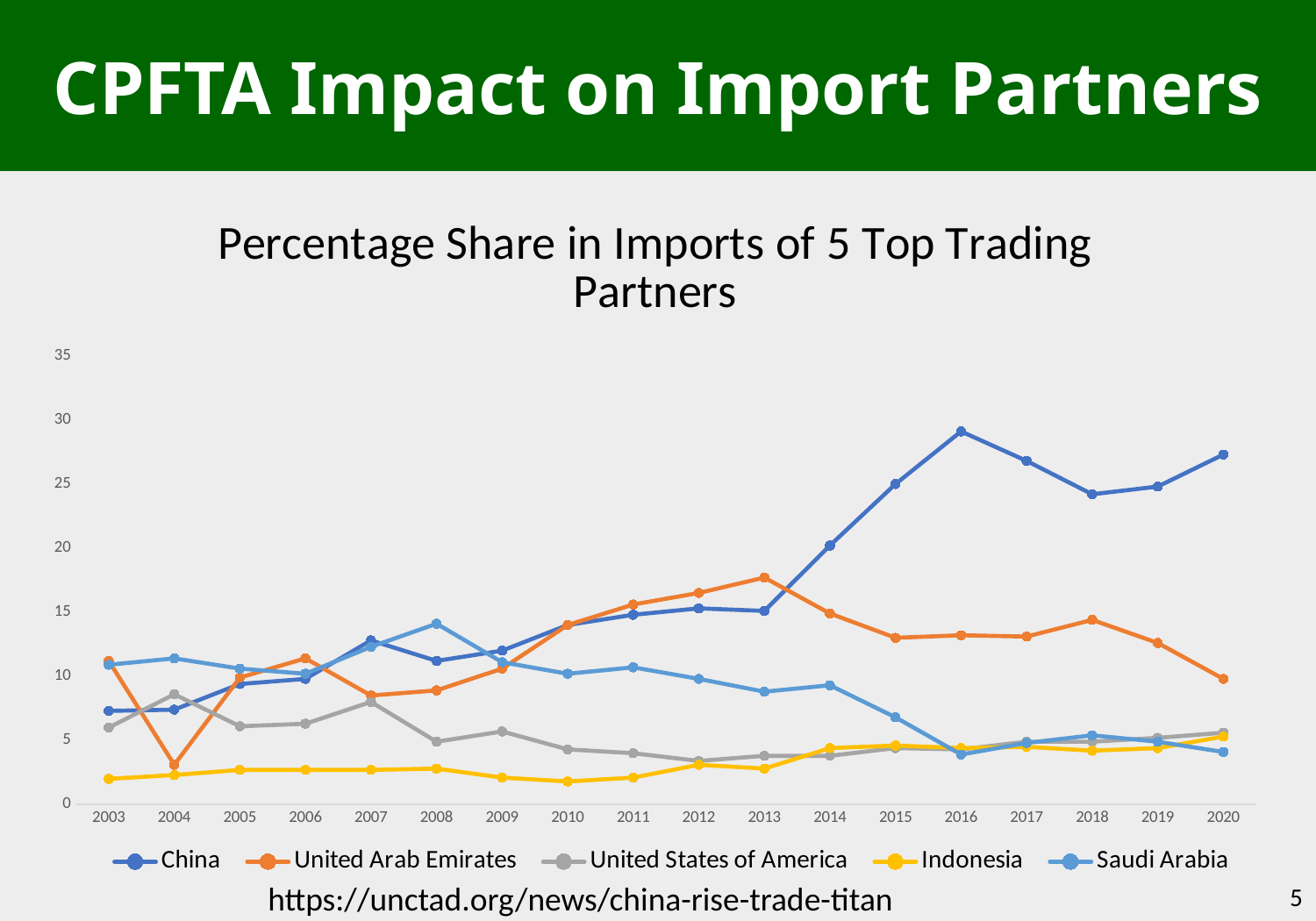
How many series does the legend list? 5 Is the value for Saudi Arabia in 2008 greater or less than 10? greater In 2013, which has the larger share: China or United Arab Emirates? United Arab Emirates What is the title of the chart? Percentage Share in Imports of 5 Top Trading Partners Is the value for China in 2016 greater or less than 25? greater Which trading partner has the lowest percentage share in 2003? Indonesia Does the share for China rise or fall from 2013 to 2016? Rise What kind of chart is shown on the slide? Line chart In which year does China reach its highest percentage share? 2016 Is the value for United Arab Emirates in 2004 greater or less than 5? less How many years are plotted along the x axis? 18 Which trading partner has the highest percentage share in 2020? China